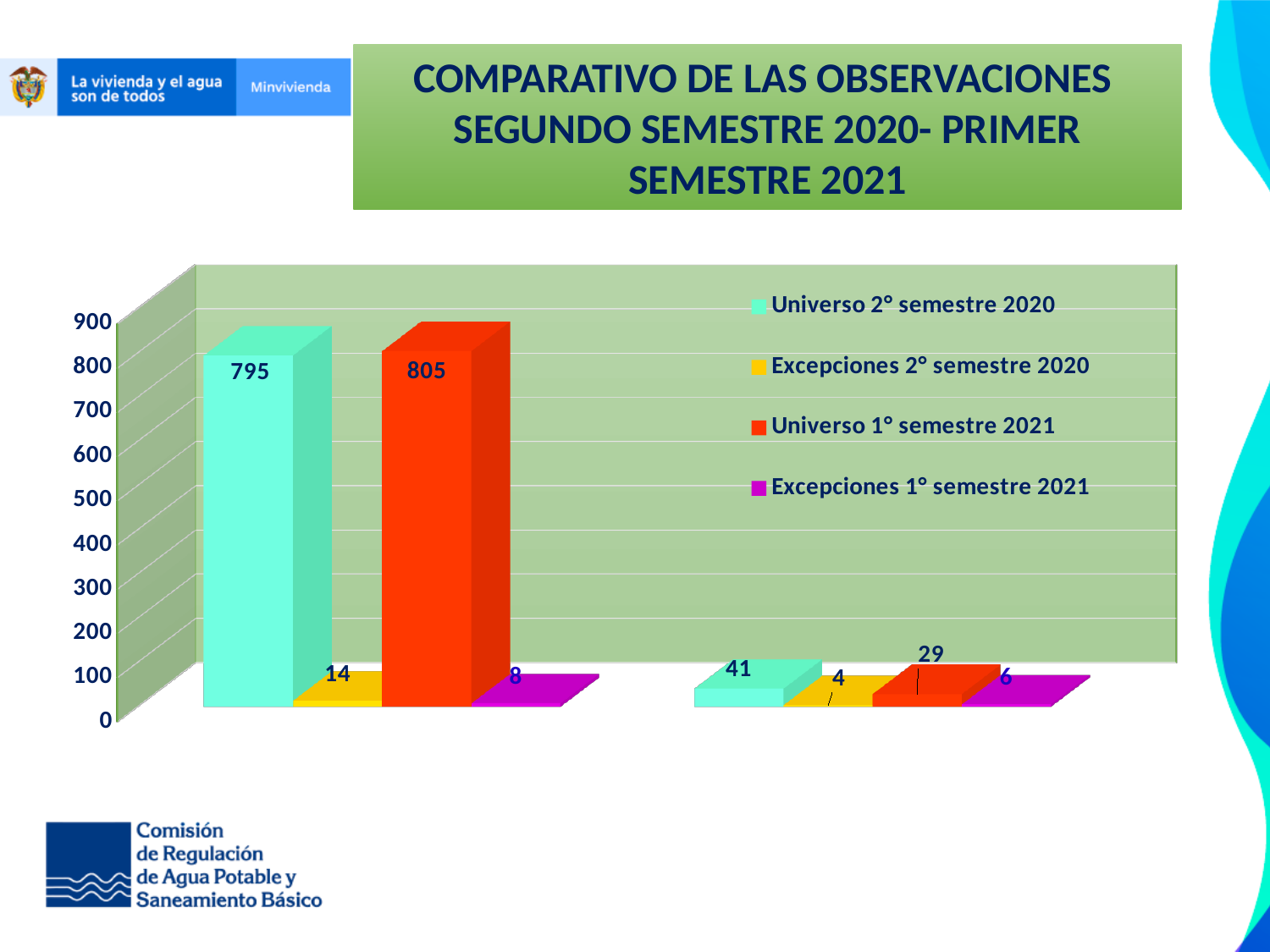
Which series has the lowest value in the right group of bars? Excepciones 2° semestre 2020 What colour represents the Universo 1° semestre 2021 series in the chart? red What is the value of the Excepciones 2° semestre 2020 bar in the left group of bars? 14 What is the value of the Universo 1° semestre 2021 bar in the left group of bars? 805 What is the difference between the Universo 1° semestre 2021 value (805) and the Universo 2° semestre 2020 value (795) in the left group of bars? 10 In the right group of bars, which is larger: Universo 2° semestre 2020 or Universo 1° semestre 2021? Universo 2° semestre 2020 How many series does the chart legend list? 4 What type of chart is shown on the slide? bar chart What is the value of the Excepciones 1° semestre 2021 bar in the right group of bars? 6 Which series has the highest value in the left group of bars? Universo 1° semestre 2021 What is the value of the Universo 2° semestre 2020 bar in the right group of bars? 41 What is the value of the Universo 2° semestre 2020 bar in the left group of bars? 795